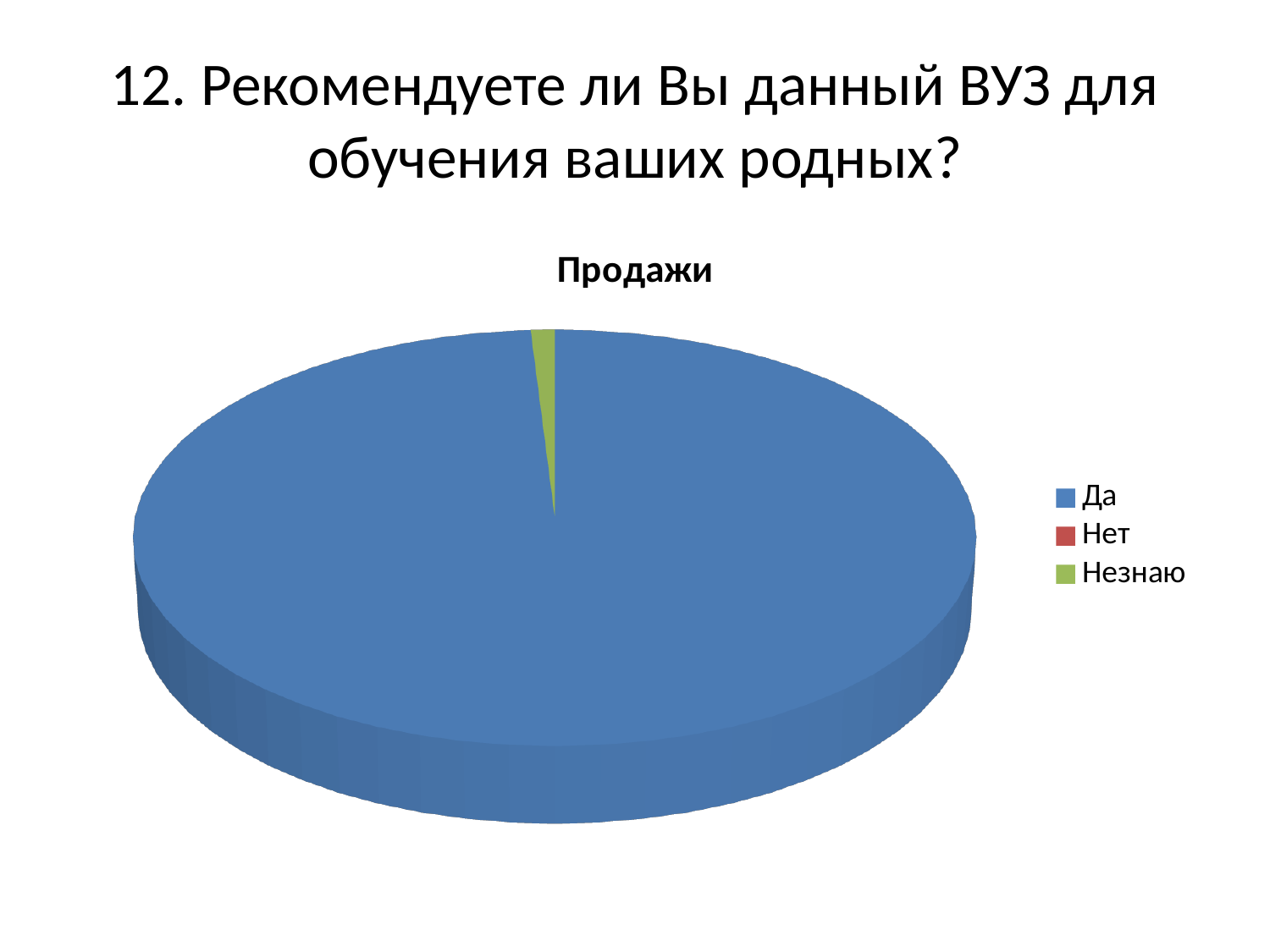
Which category has the largest slice of the pie? Да What is the title of the chart? Продажи How many categories does the chart's legend list? 3 Which slice is larger, Да or Незнаю? Да What colour is the slice for Да? blue What kind of chart is shown on the slide? pie chart Which category is shown in green in the legend? Незнаю